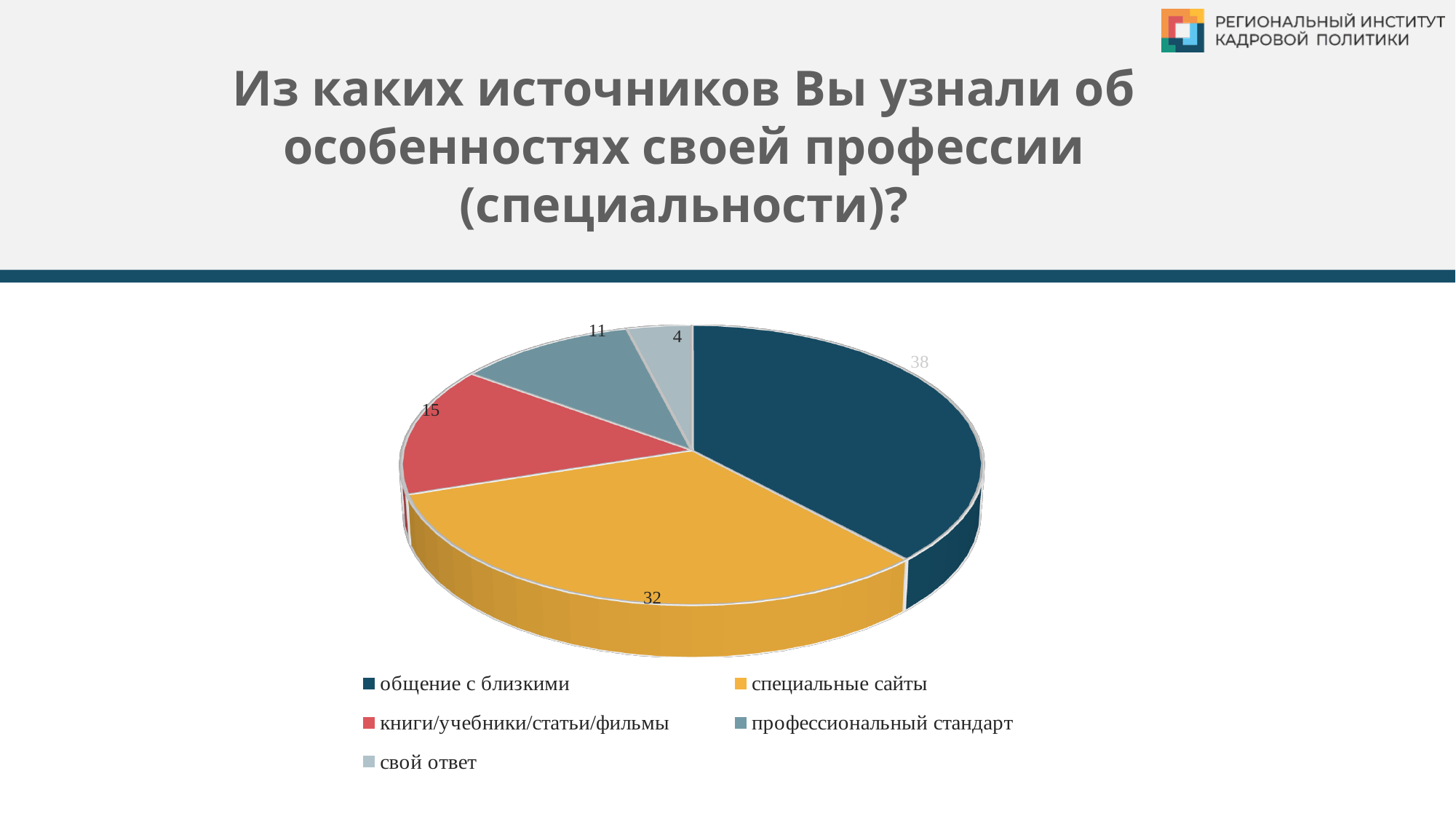
How many categories does the pie chart have? 5 What is the value for "книги/учебники/статьи/фильмы"? 15 Which category has the largest slice? общение с близкими What is the value for "свой ответ"? 4 Which category has the smallest slice? свой ответ What is the value for "профессиональный стандарт"? 11 What type of chart is shown on the slide? pie chart What colour is the slice for "специальные сайты"? yellow Which is larger, the value for "книги/учебники/статьи/фильмы" or the value for "профессиональный стандарт"? книги/учебники/статьи/фильмы What is the value for "общение с близкими"? 38 What is the difference between the values for "общение с близкими" and "специальные сайты"? 6 What is the value for "специальные сайты"? 32